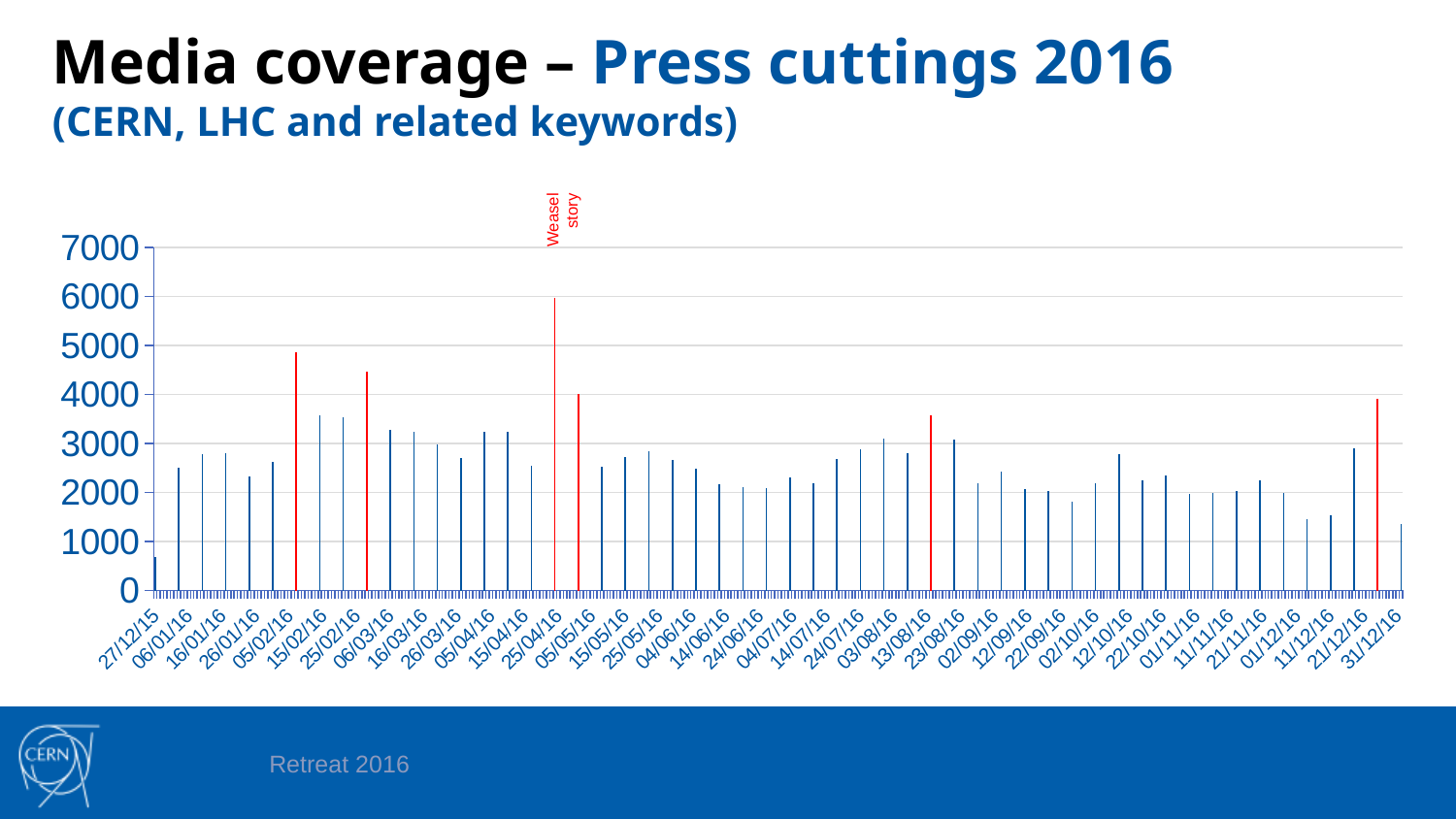
Is the value for 25/02/16 greater or less than 4000? greater Is the value for 27/12/15 greater or less than 1000? less Is the value for 31/12/16 greater or less than 2000? less What kind of chart is shown on the slide? bar chart What is the highest value shown on the y axis? 7000 Which is larger, the value for 05/02/16 or the value for 13/08/16? 05/02/16 What annotation labels the tallest bar in the chart? Weasel story Which is larger, the value for 27/12/15 or the value for 31/12/16? 31/12/16